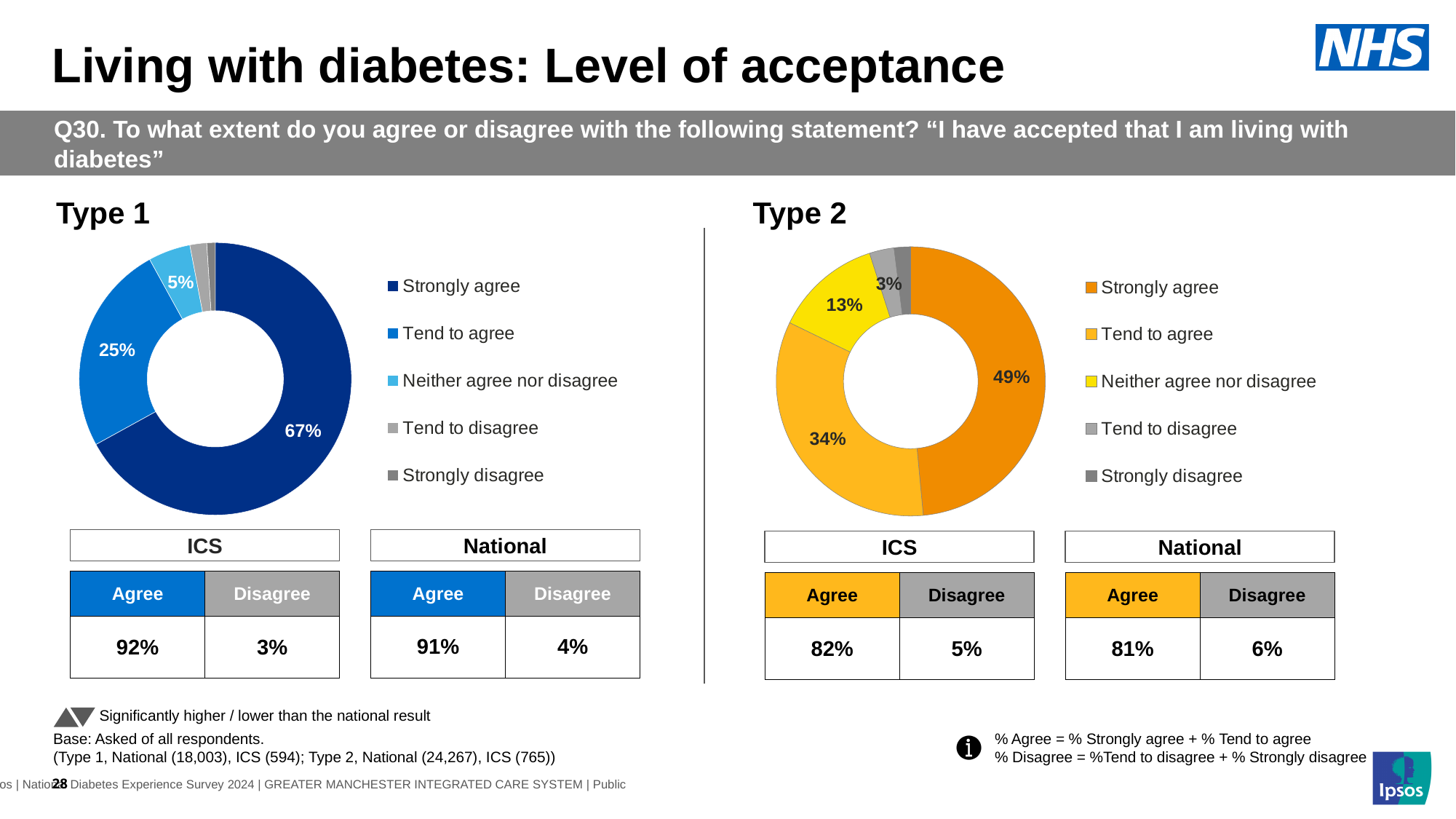
In the Type 1 chart, what is the difference between the Strongly agree and Tend to agree shares? 42% Which chart shows a larger Strongly agree share, Type 1 or Type 2? Type 1 In the Type 2 chart, which response category has the largest share? Strongly agree How many response categories does the legend of the Type 2 chart list? 5 In the Type 2 chart, what percentage of respondents tend to agree? 34% In the Type 1 chart, which response category has the largest share? Strongly agree In the Type 1 chart, what percentage of respondents tend to agree? 25% In the Type 1 chart, what percentage of respondents strongly agree? 67% In the Type 1 chart, what percentage neither agree nor disagree? 5% In the Type 2 chart, what percentage neither agree nor disagree? 13% What kind of chart is used for Type 1? Donut chart In the Type 2 chart, what percentage of respondents strongly agree? 49%